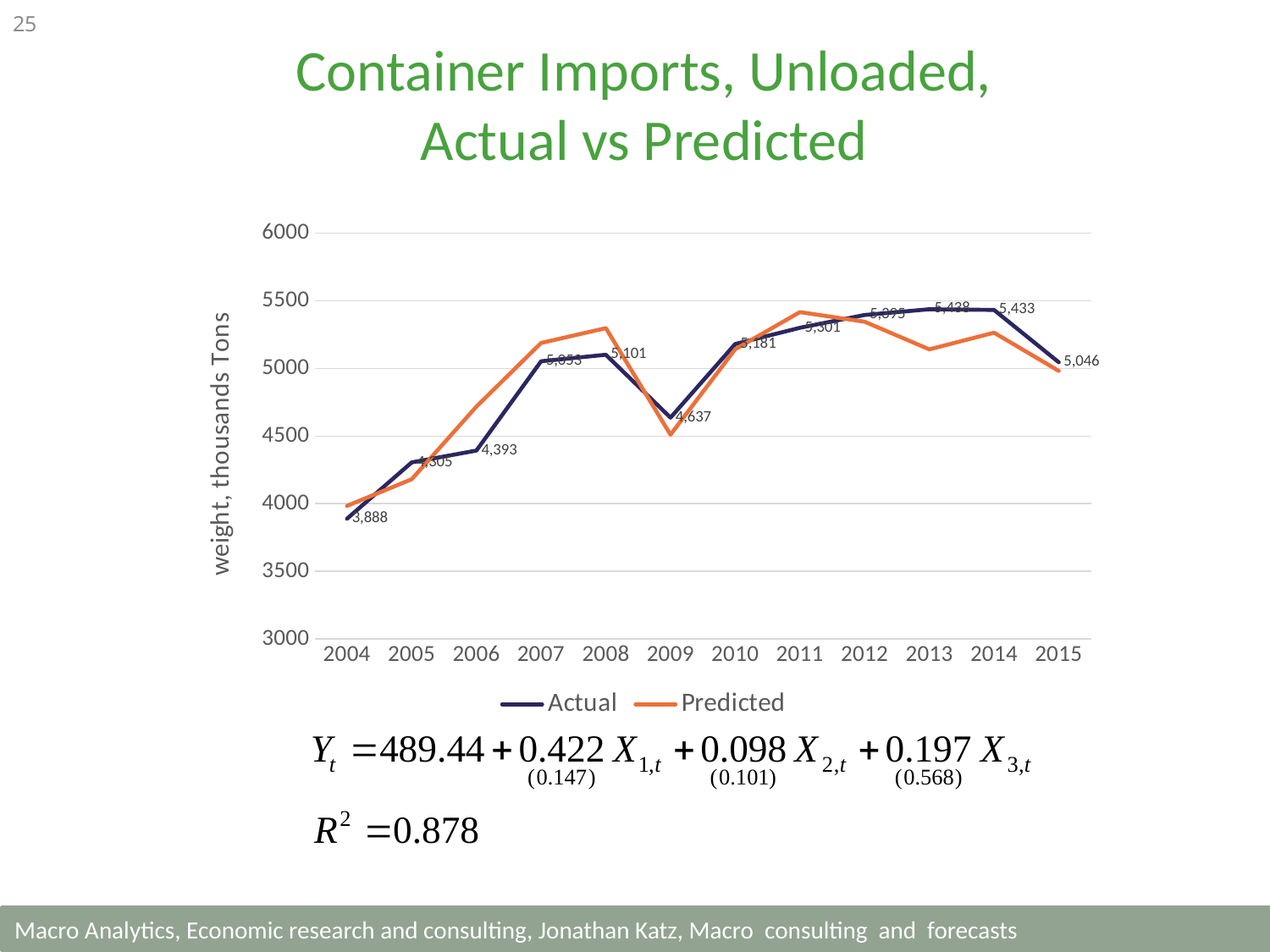
How many years are plotted along the x axis? 12 What is the label on the y axis? weight, thousands Tons What is the Actual value for 2015? 5,046 What type of chart is shown on the slide? line chart What is the difference between the Actual values for 2008 and 2009? 464 In which year is the Actual value lowest? 2004 Is the Predicted value for 2011 greater or less than 5000? greater How many series does the legend list? 2 What is the Actual value for 2009? 4,637 In 2008, which is larger, the Actual or the Predicted value? Predicted What is the difference between the Actual values for 2014 and 2015? 387 What is the Actual value for 2004? 3,888